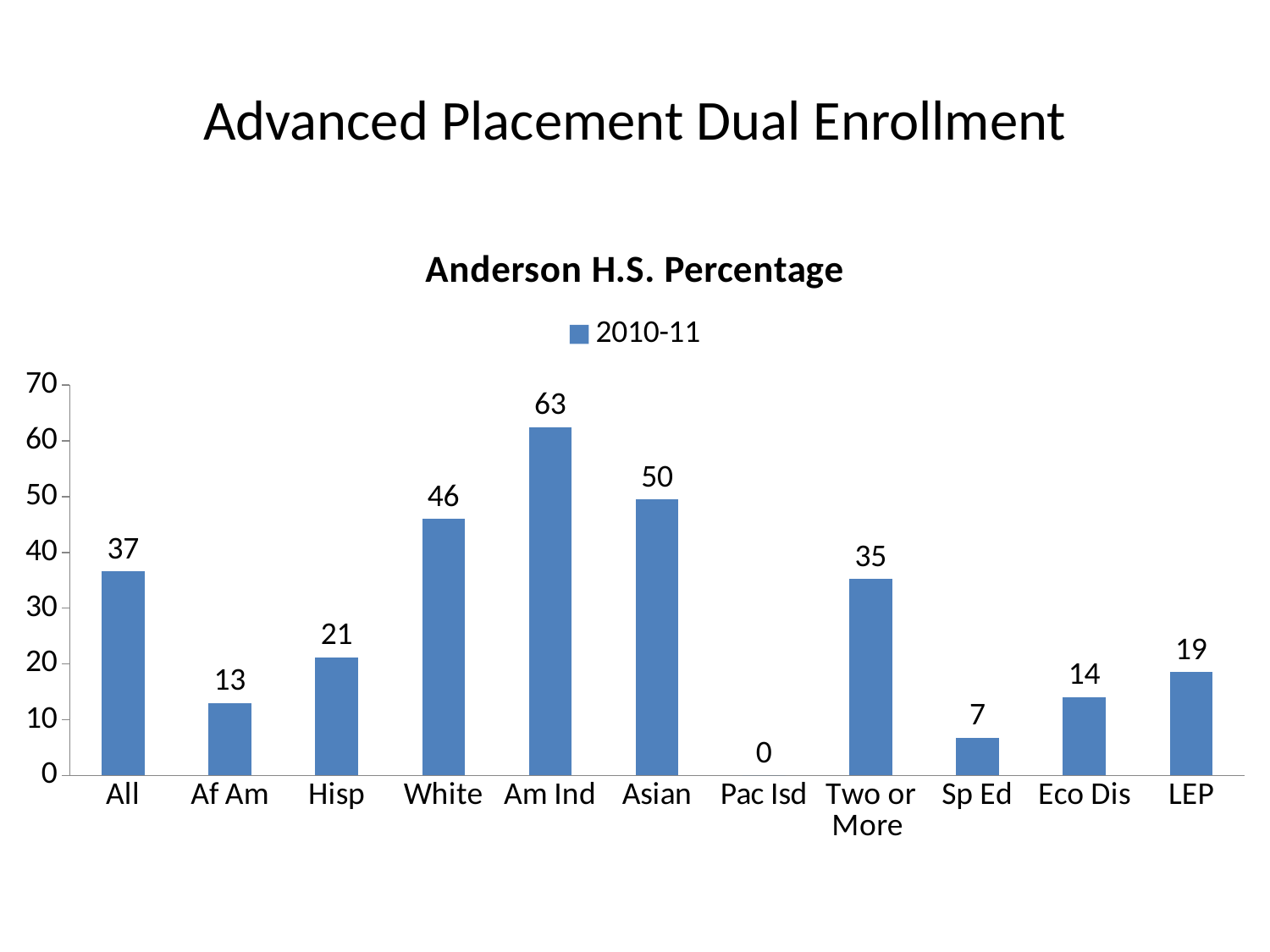
How many series does the legend list? 1 What is the difference between the values for White and Af Am? 33 What is the value for Am Ind? 63 Which category has the lowest value? Pac Isd Which category has the highest value? Am Ind How many categories are shown on the x axis? 11 Which is larger, the value for Asian or the value for All? Asian What is the title of the chart? Anderson H.S. Percentage What is the value for Eco Dis? 14 What is the value for Two or More? 35 What series name is shown in the legend? 2010-11 What kind of chart is shown? bar chart